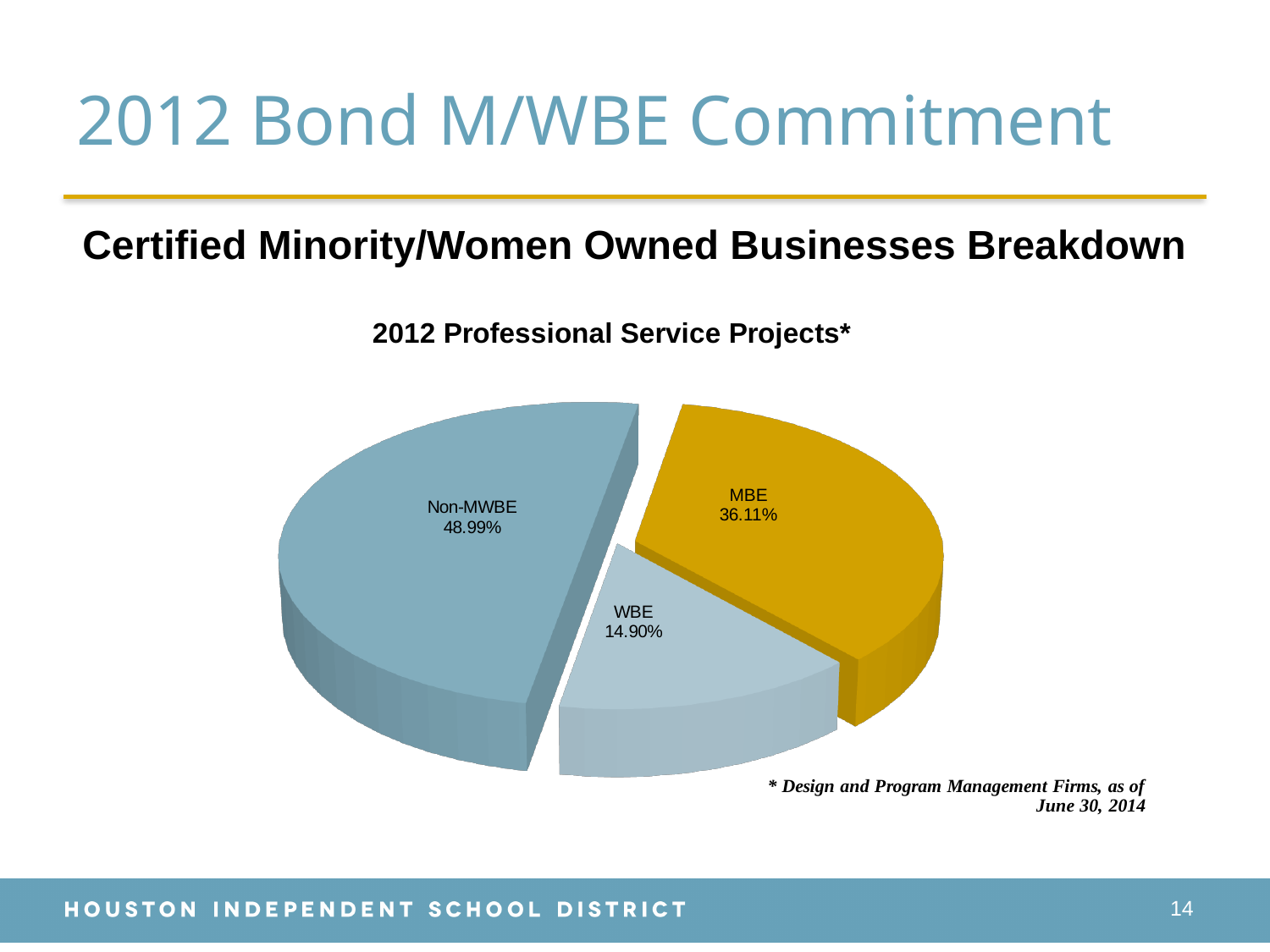
Which slice of the pie is the smallest? WBE What share of the pie does WBE represent? 14.90% What colour is the MBE slice? Gold What is the title of the chart? 2012 Professional Service Projects* Which slice of the pie is the largest? Non-MWBE What share of the pie does MBE represent? 36.11% What is the difference in percentage points between the Non-MWBE and MBE slices? 12.88 What kind of chart is shown on the slide? Pie chart Which is larger, the MBE slice or the WBE slice? MBE How many slices does the pie chart have? 3 What share of the pie does Non-MWBE represent? 48.99% What is the difference in percentage points between the MBE and WBE slices? 21.21